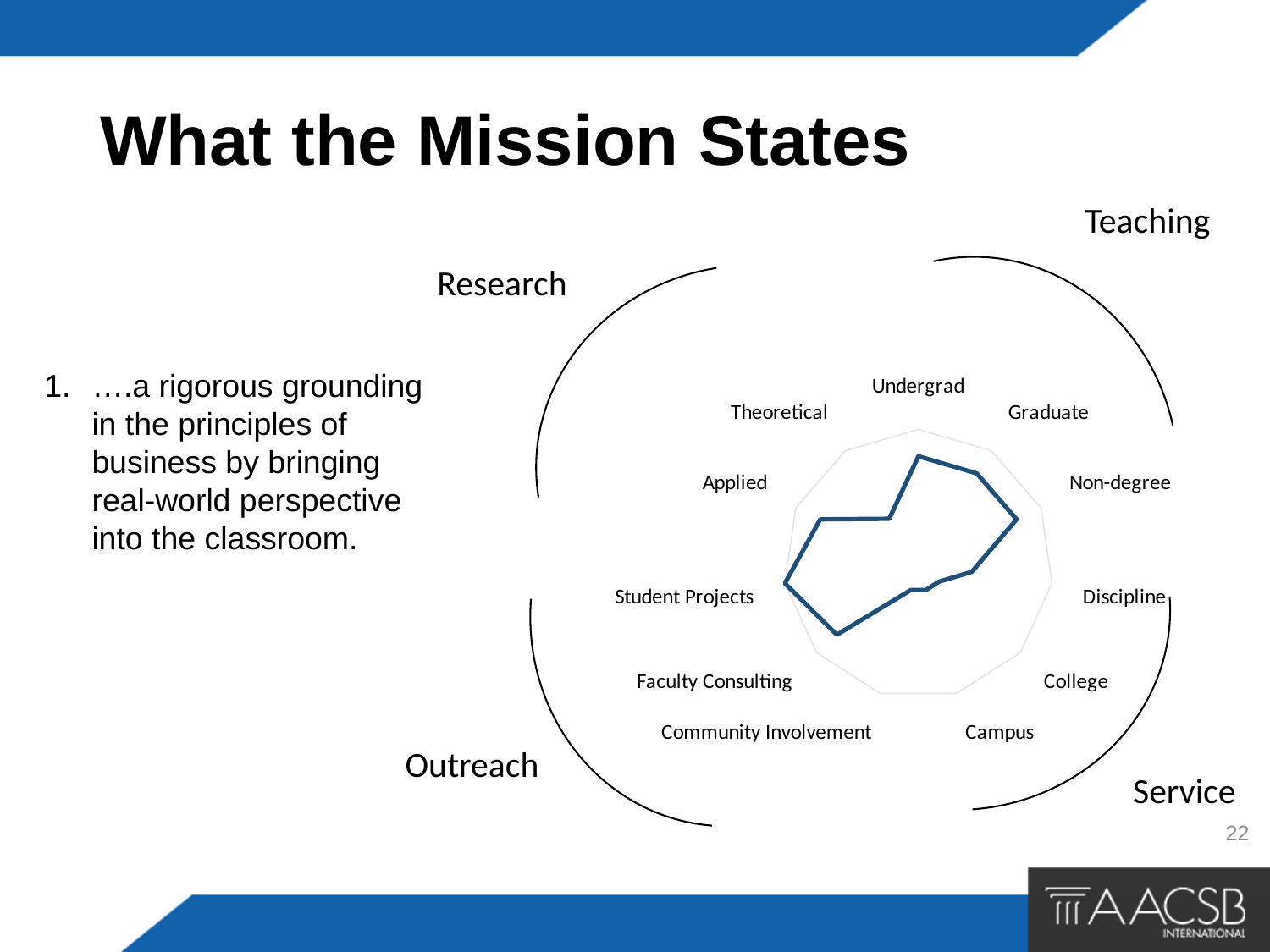
Which is larger on the radar chart, the value for Non-degree or the value for Discipline? Non-degree How many categories are plotted around the radar chart? 11 Which is larger on the radar chart, the value for Graduate or the value for College? Graduate What are the four area labels placed around the outside of the radar chart? Teaching, Research, Outreach, Service Which category has the highest value on the radar chart? Student Projects Which is larger on the radar chart, the value for Student Projects or the value for Campus? Student Projects Which category label sits at the top of the radar chart? Undergrad What kind of chart is shown on the slide? radar chart